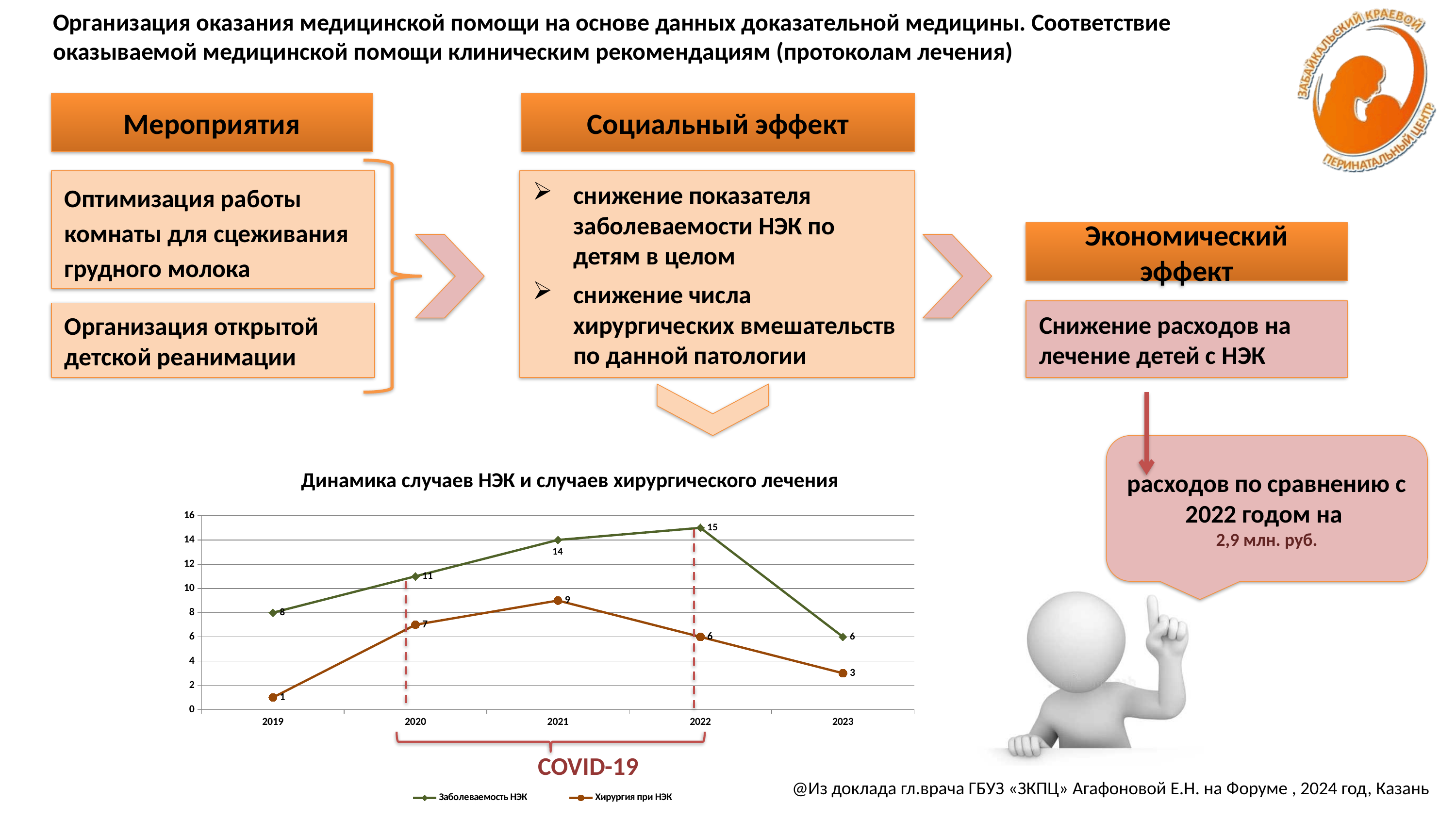
What is the value of Заболеваемость НЭК in 2022? 15 What type of chart is shown on the slide? Line chart In which year is Заболеваемость НЭК highest? 2022 Which is larger in 2020: Заболеваемость НЭК or Хирургия при НЭК? Заболеваемость НЭК In which year is Хирургия при НЭК lowest? 2019 How many years are shown on the x axis of the chart? 5 What is the value of Хирургия при НЭК in 2023? 3 How many series does the chart legend list? 2 What is the difference between Заболеваемость НЭК and Хирургия при НЭК in 2021? 5 What is the value of Хирургия при НЭК in 2019? 1 By how much did Заболеваемость НЭК fall from 2022 to 2023? 9 What is the title of the chart? Динамика случаев НЭК и случаев хирургического лечения